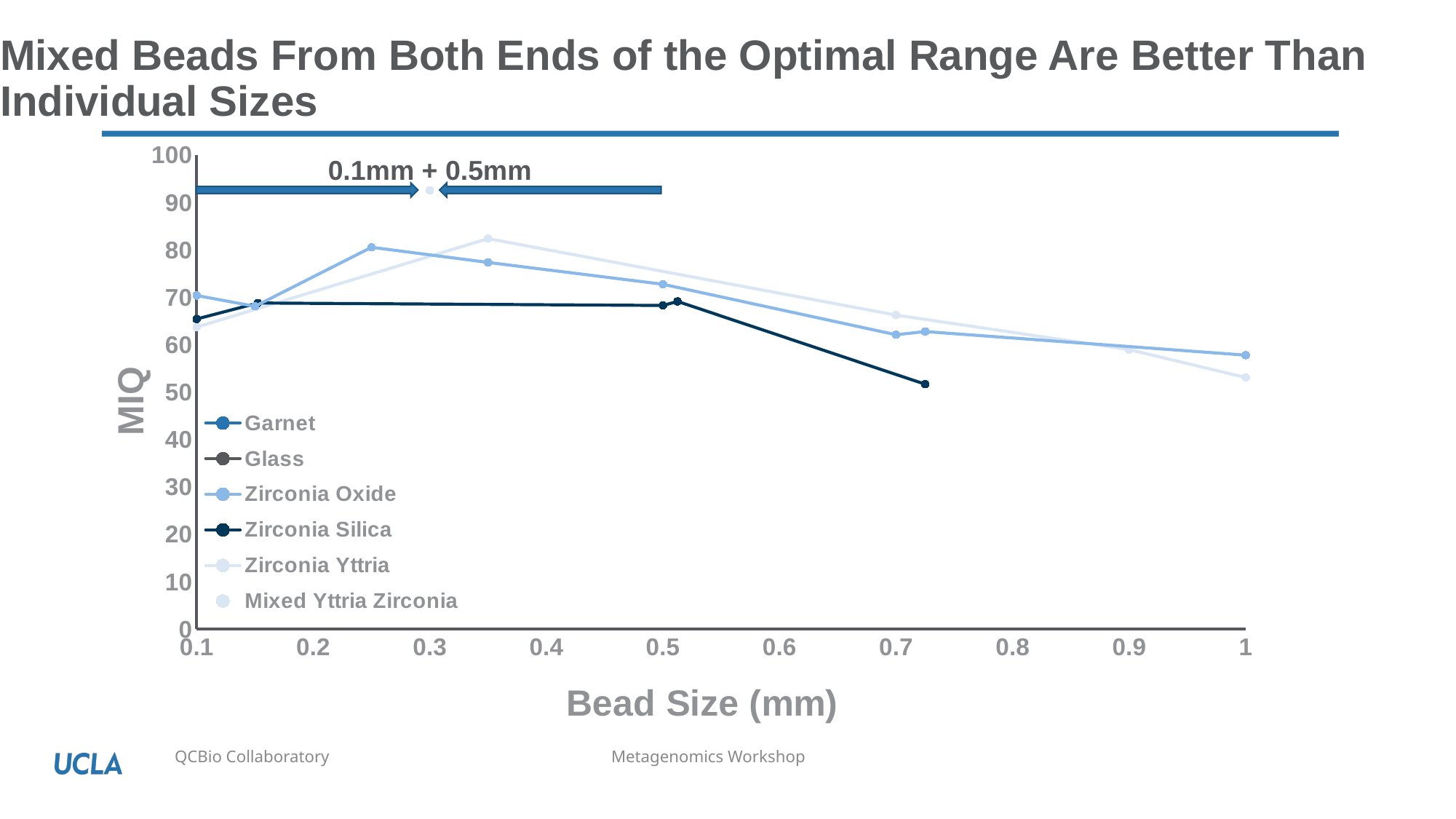
What kind of chart is shown on the slide? Line chart At a bead size of 0.1 mm, which series has the higher MIQ, Zirconia Oxide or Zirconia Silica? Zirconia Oxide Is the MIQ value for Zirconia Silica at its largest bead size (about 0.7 mm) greater or less than 60? less What is the title of the y axis? MIQ Is the MIQ value for Mixed Yttria Zirconia greater or less than 80? greater Is the MIQ value for Zirconia Yttria at a bead size of 1 mm greater or less than 60? less What is the title of the x axis? Bead Size (mm) How many series does the legend list? 6 Which series reaches the highest MIQ value on the chart? Mixed Yttria Zirconia At a bead size of 1 mm, which series has the higher MIQ, Zirconia Oxide or Zirconia Yttria? Zirconia Oxide Does the MIQ for Zirconia Silica rise or fall between bead sizes of 0.5 mm and about 0.7 mm? Fall